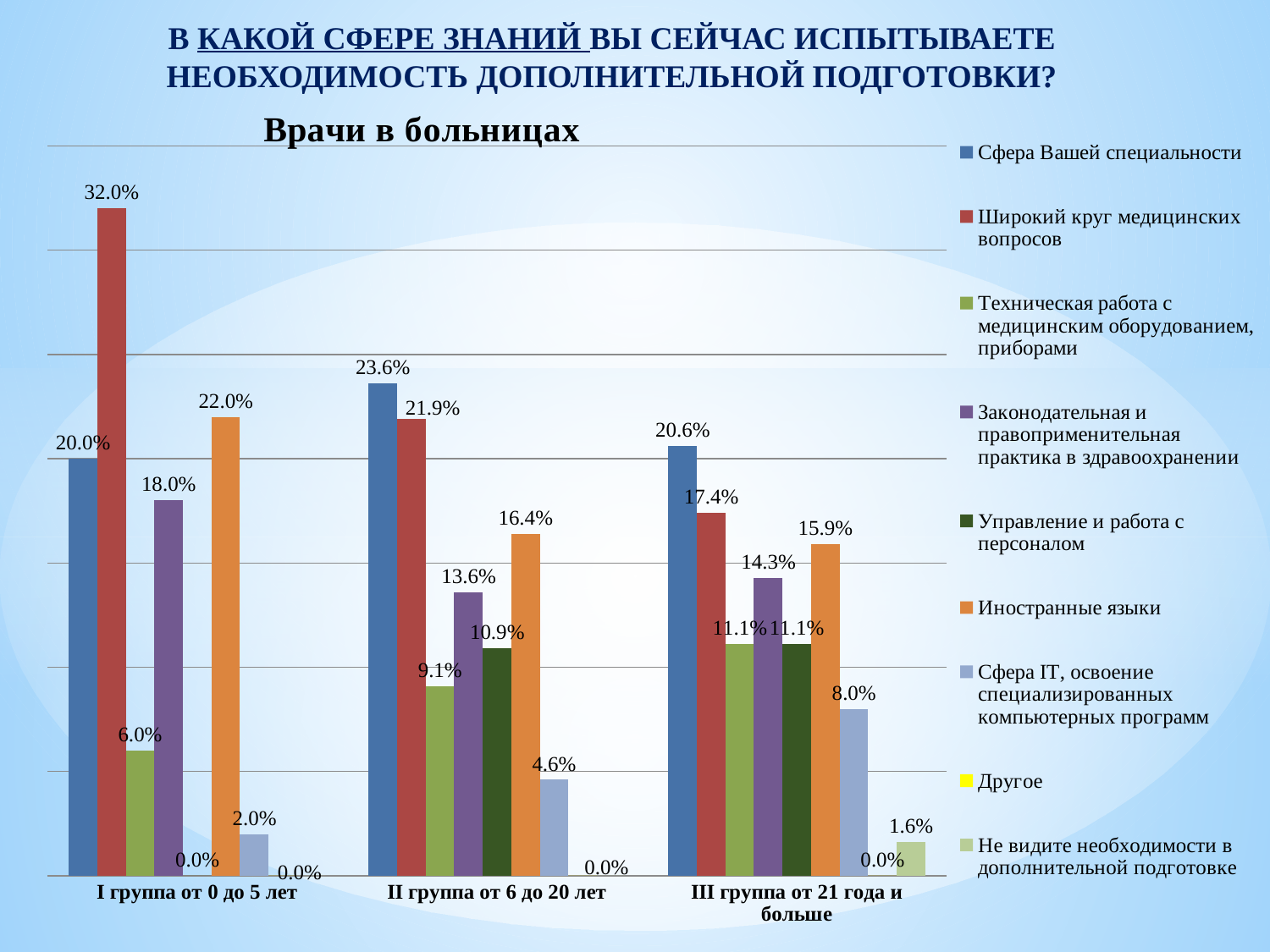
Which series has the highest value in 'II группа от 6 до 20 лет'? Сфера Вашей специальности What is the value for 'Сфера IT, освоение специализированных компьютерных программ' in 'III группа от 21 года и больше'? 8.0% What is the value for 'Широкий круг медицинских вопросов' in 'I группа от 0 до 5 лет'? 32.0% Does the value for 'Широкий круг медицинских вопросов' rise or fall from group I to group III? Falls What kind of chart is shown on the slide? Bar chart Which series has the highest value in 'I группа от 0 до 5 лет'? Широкий круг медицинских вопросов In 'I группа от 0 до 5 лет', what is the difference between 'Широкий круг медицинских вопросов' and 'Сфера Вашей специальности'? 12.0 percentage points What is the value for 'Не видите необходимости в дополнительной подготовке' in 'III группа от 21 года и больше'? 1.6% Is the value for 'Законодательная и правоприменительная практика в здравоохранении' larger in 'II группа от 6 до 20 лет' or in 'III группа от 21 года и больше'? III группа от 21 года и больше How many groups (categories) are shown on the x axis? 3 What is the value for 'Иностранные языки' in 'II группа от 6 до 20 лет'? 16.4% How many series does the legend list? 9